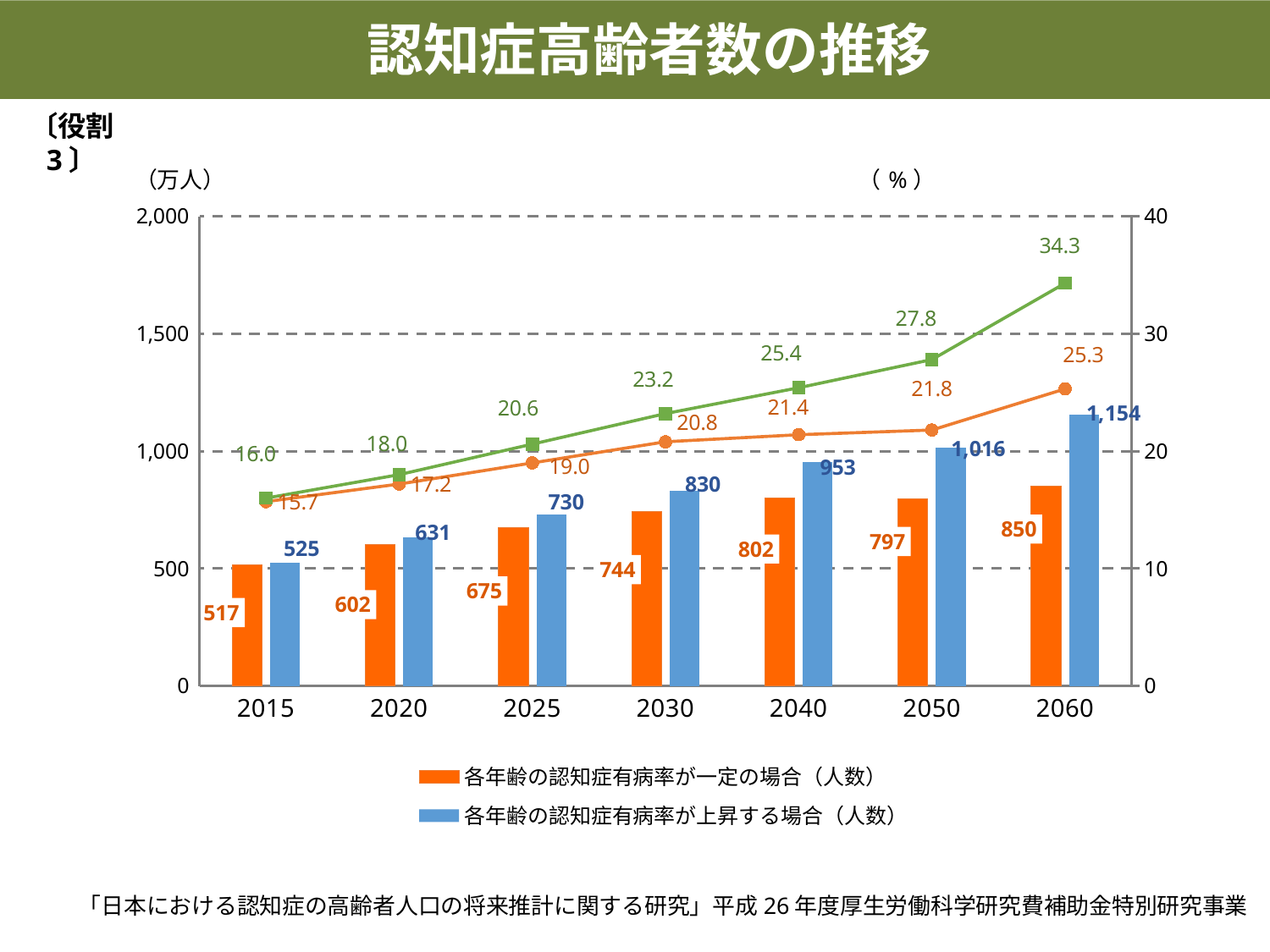
What is the difference between the blue bar and the orange bar in 2050? 219 What is the value of the orange bar (各年齢の認知症有病率が一定の場合) for 2015? 517 How many years are shown on the x axis? 7 Does the green line rise or fall from 2015 to 2060? rise What is the value of the blue bar (各年齢の認知症有病率が上昇する場合) for 2060? 1,154 In which year is the blue bar (有病率が上昇する場合) lowest? 2015 What value does the orange line show for 2025? 19.0 What is the value of the blue bar for 2040? 953 In which year is the orange bar (有病率が一定の場合) highest? 2060 What value does the green line show for 2060? 34.3 Which is larger in 2030, the orange bar or the blue bar? the blue bar (830) How many series does the legend list? 2